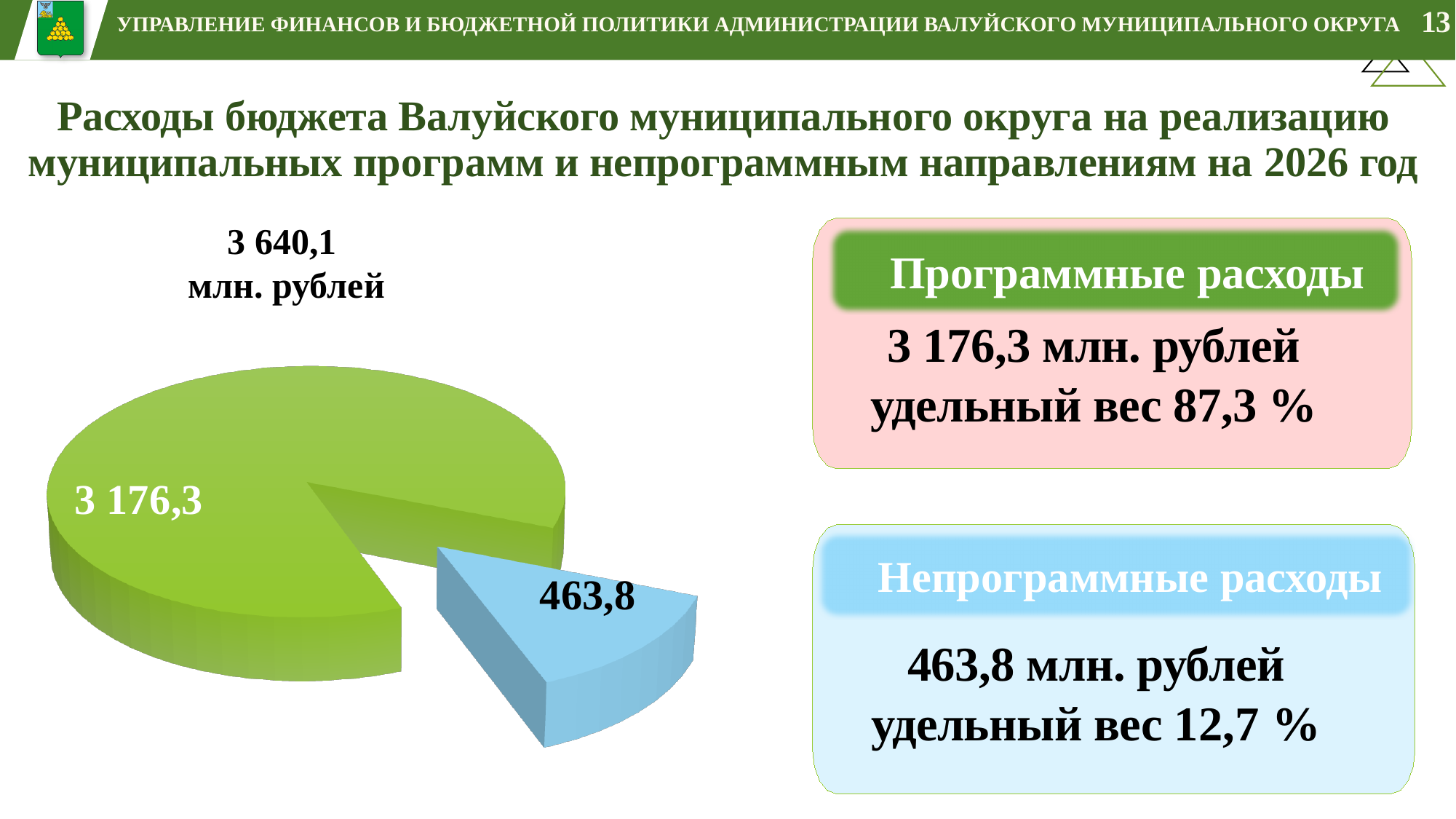
How many slices does the pie chart have? 2 What is the difference between Программные расходы (3 176,3) and Непрограммные расходы (463,8)? 2 712,5 Which is larger: Программные расходы or Непрограммные расходы? Программные расходы What colour is the slice representing Непрограммные расходы? blue What is the value of the green slice (Программные расходы) in the pie chart? 3 176,3 Which slice of the pie chart is the smallest? Непрограммные расходы (463,8) What share of the total do Программные расходы make up? 87,3 % What is the total of the two slices shown above the pie chart? 3 640,1 млн. рублей Which slice of the pie chart is the largest? Программные расходы (3 176,3) What share of the total do Непрограммные расходы make up? 12,7 % What kind of chart is shown on the slide? pie chart What is the value of the blue slice (Непрограммные расходы) in the pie chart? 463,8